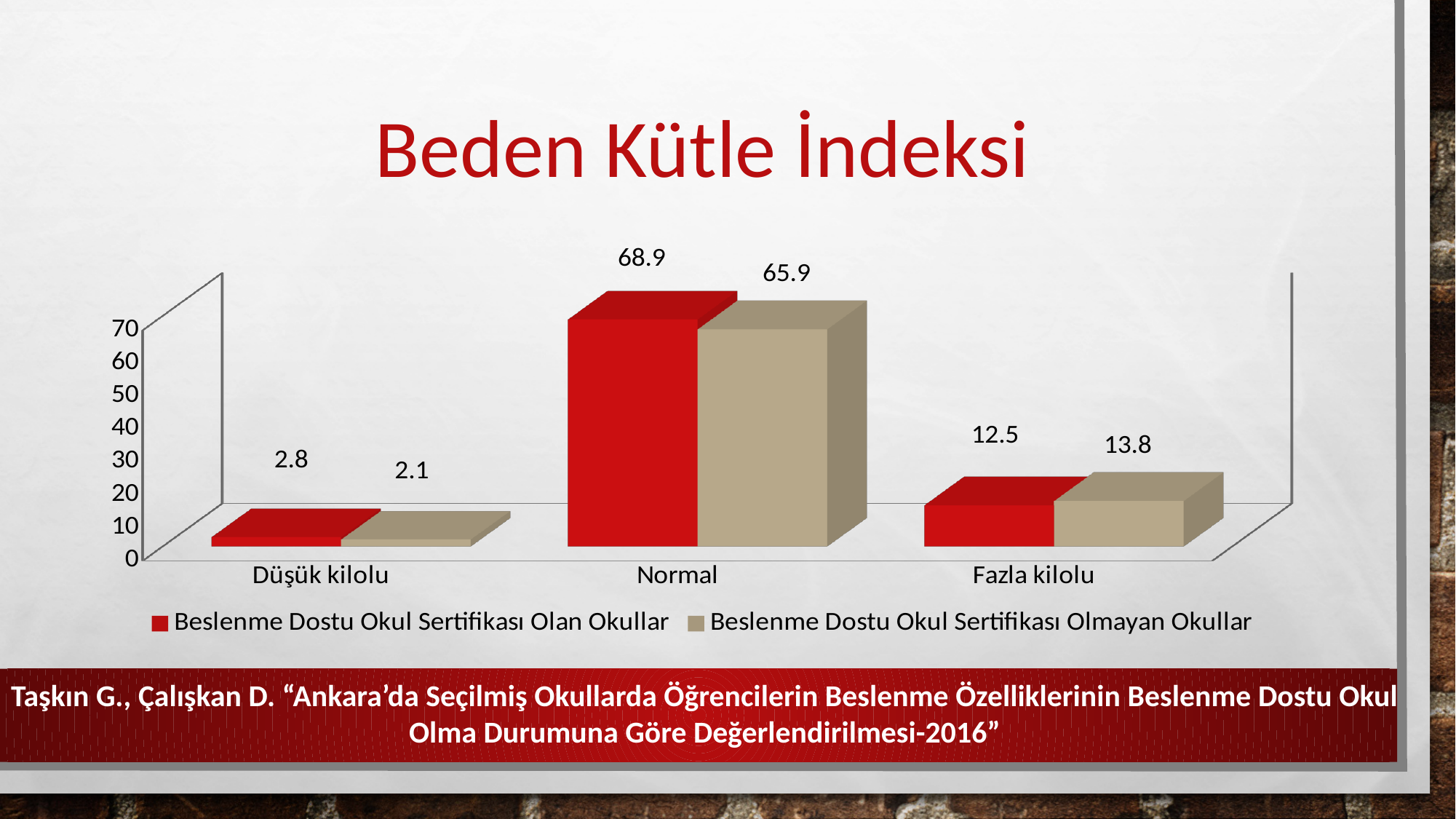
What is the value for Normal in the Beslenme Dostu Okul Sertifikası Olan Okullar series? 68.9 What is the difference between the two series' values for Normal? 3.0 What is the value for Düşük kilolu in the Beslenme Dostu Okul Sertifikası Olan Okullar series? 2.8 Which category has the lowest value in the Beslenme Dostu Okul Sertifikası Olan Okullar series? Düşük kilolu What kind of chart is shown on the slide? Bar chart Which category has the highest value in the Beslenme Dostu Okul Sertifikası Olmayan Okullar series? Normal For Fazla kilolu, which series has the larger value? Beslenme Dostu Okul Sertifikası Olmayan Okullar What is the difference between the two series' values for Fazla kilolu? 1.3 How many series does the legend list? 2 What is the value for Fazla kilolu in the Beslenme Dostu Okul Sertifikası Olmayan Okullar series? 13.8 How many categories are shown on the x axis? 3 What is the title of the chart? Beden Kütle İndeksi